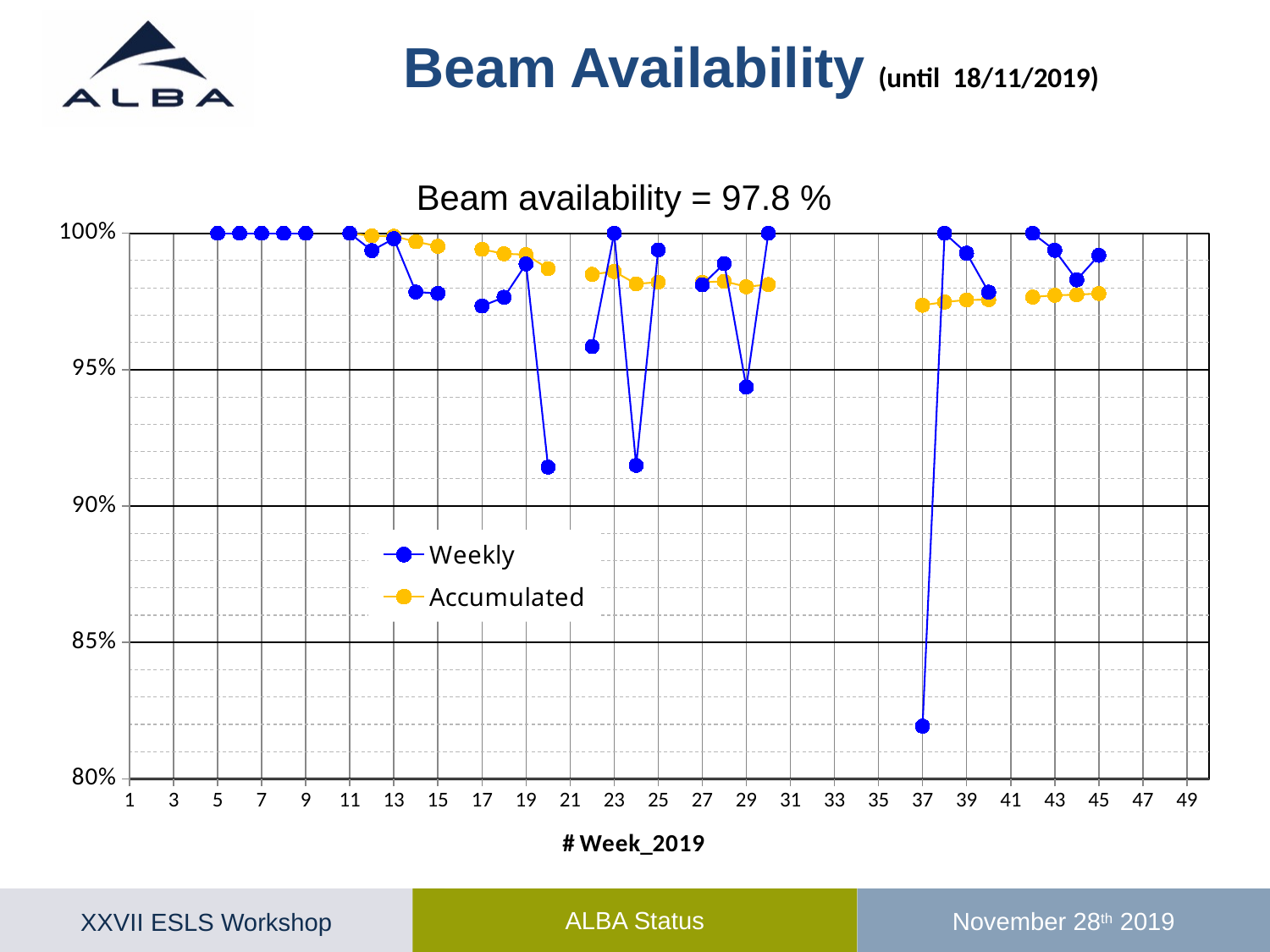
What kind of chart is shown on the slide? line chart What are the two series named in the legend? Weekly and Accumulated Is the Weekly value for week 37 greater or less than 85%? less Is the Accumulated value for week 45 greater or less than 95%? greater What is the title of the chart? Beam availability = 97.8 % Is the Weekly value for week 22 greater or less than 95%? greater Which is larger, the Weekly value for week 37 or for week 38? week 38 What is the Weekly value for week 5? 100% What is the Weekly value for week 23? 100% How many series does the legend list? 2 In which week does the Weekly series reach its lowest value? 37